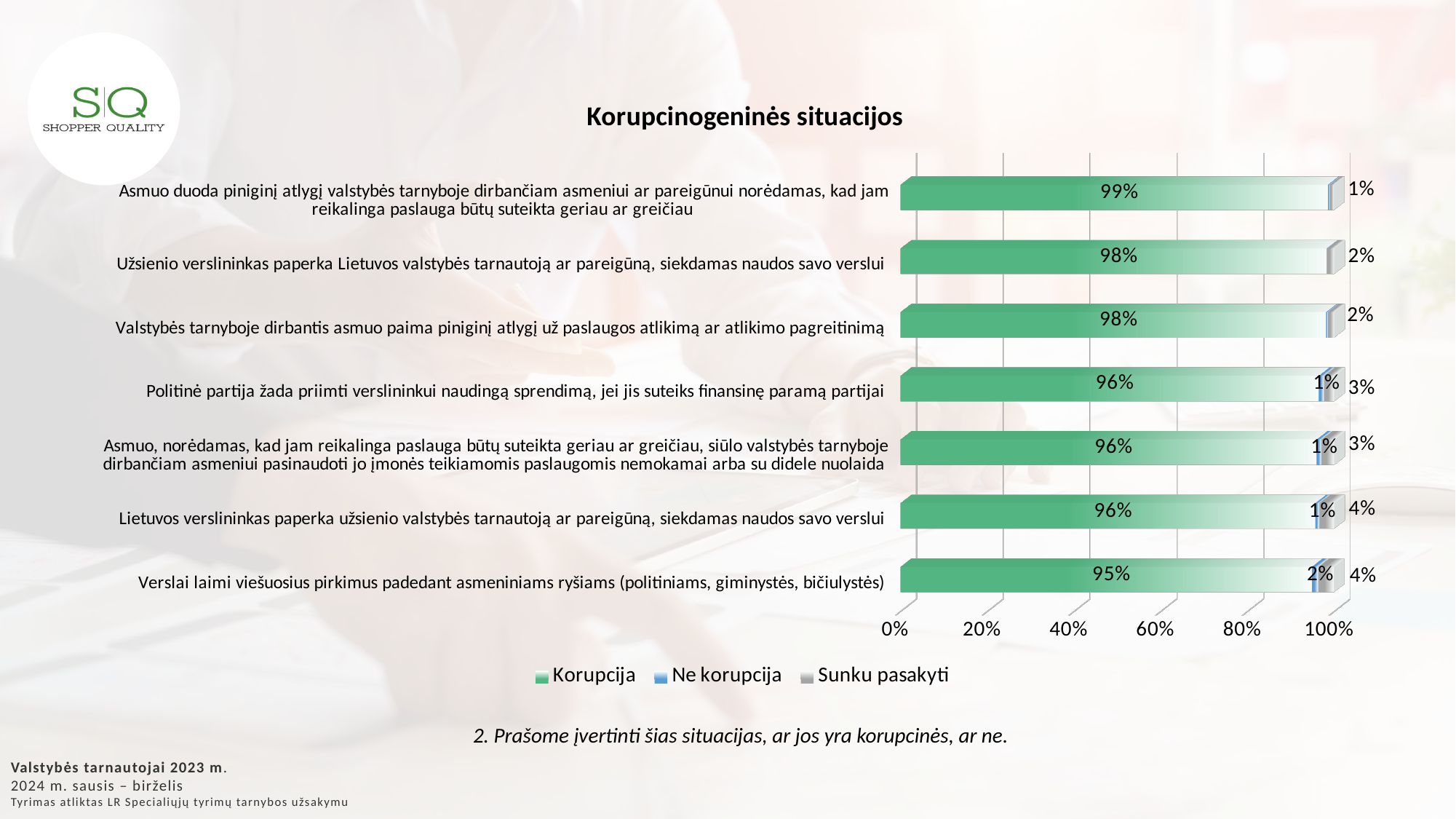
How many series does the legend list? 3 Which has a larger Korupcija value: "Užsienio verslininkas paperka Lietuvos valstybės tarnautoją ar pareigūną, siekdamas naudos savo verslui" or "Politinė partija žada priimti verslininkui naudingą sprendimą, jei jis suteiks finansinę paramą partijai"? Užsienio verslininkas paperka Lietuvos valstybės tarnautoją ar pareigūną, siekdamas naudos savo verslui What kind of chart is shown on the slide? Stacked bar chart What is the title of the chart? Korupcinogeninės situacijos How many situations (categories) are shown in the chart? 7 What is the difference in percentage points between the highest Korupcija value (99%) and the lowest Korupcija value (95%)? 4 percentage points What is the Sunku pasakyti value for "Verslai laimi viešuosius pirkimus padedant asmeniniams ryšiams (politiniams, giminystės, bičiulystės)"? 4% Which situation has the lowest Korupcija value? Verslai laimi viešuosius pirkimus padedant asmeniniams ryšiams (politiniams, giminystės, bičiulystės) What is the Korupcija value for "Asmuo duoda piniginį atlygį valstybės tarnyboje dirbančiam asmeniui ar pareigūnui norėdamas, kad jam reikalinga paslauga būtų suteikta geriau ar greičiau"? 99% What is the Ne korupcija value for "Politinė partija žada priimti verslininkui naudingą sprendimą, jei jis suteiks finansinę paramą partijai"? 1% What is the Korupcija value for "Verslai laimi viešuosius pirkimus padedant asmeniniams ryšiams (politiniams, giminystės, bičiulystės)"? 95% Which situation has the highest Korupcija value? Asmuo duoda piniginį atlygį valstybės tarnyboje dirbančiam asmeniui ar pareigūnui norėdamas, kad jam reikalinga paslauga būtų suteikta geriau ar greičiau